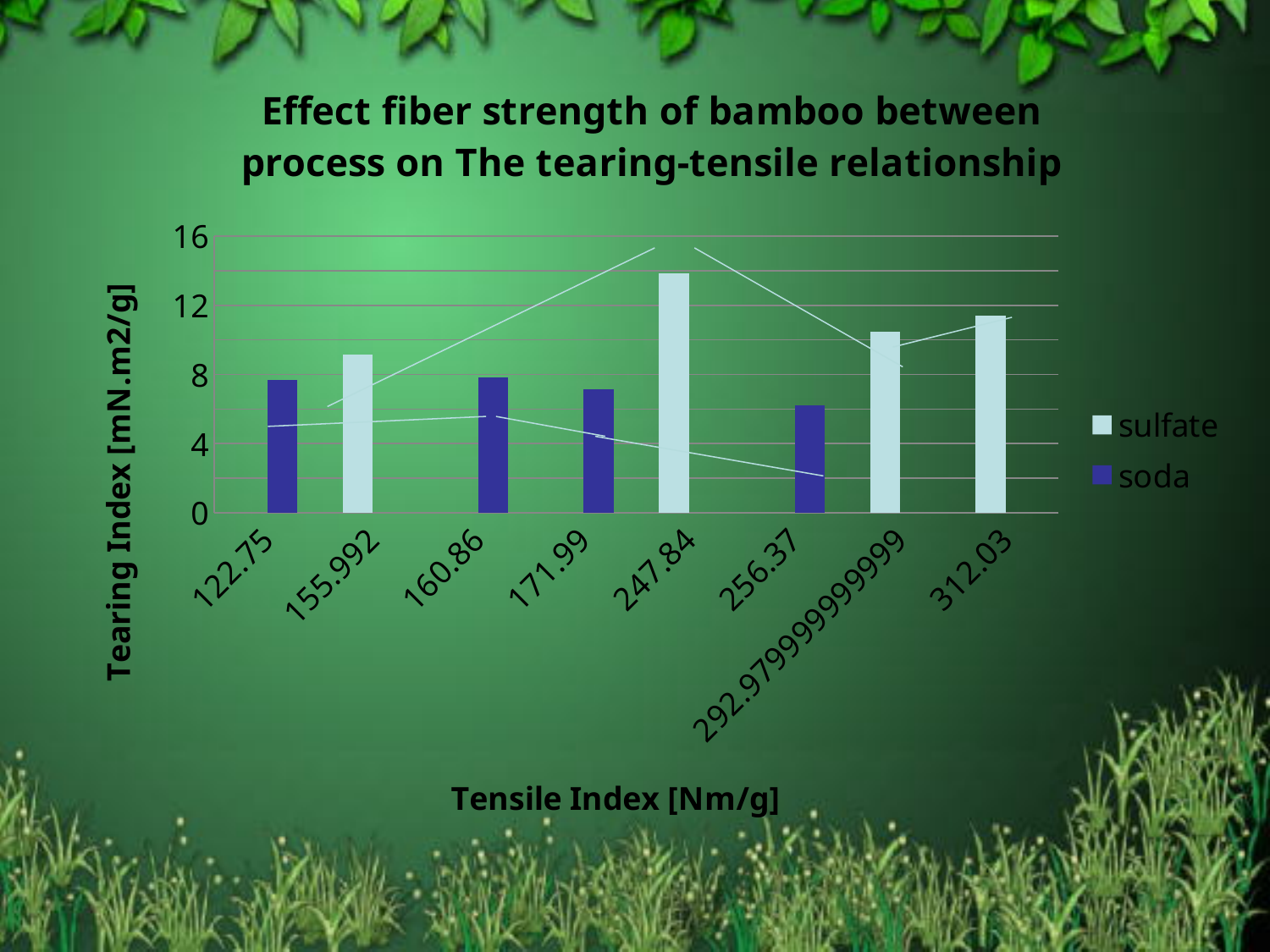
What kind of chart is shown on the slide? bar chart How many categories are shown on the x axis? 8 Which tensile index category has the highest tearing index bar? 247.84 Which tensile index category has the lowest tearing index bar? 256.37 Is the tearing index value for 312.03 greater or less than 12? less Is the tearing index value for 155.992 greater or less than 8? greater Is the tearing index value for 247.84 greater or less than 12? greater What is the label of the y axis? Tearing Index [mN.m2/g] Which has the larger tearing index bar, 247.84 or 312.03? 247.84 How many series does the legend list? 2 Which series is shown with dark blue bars? soda